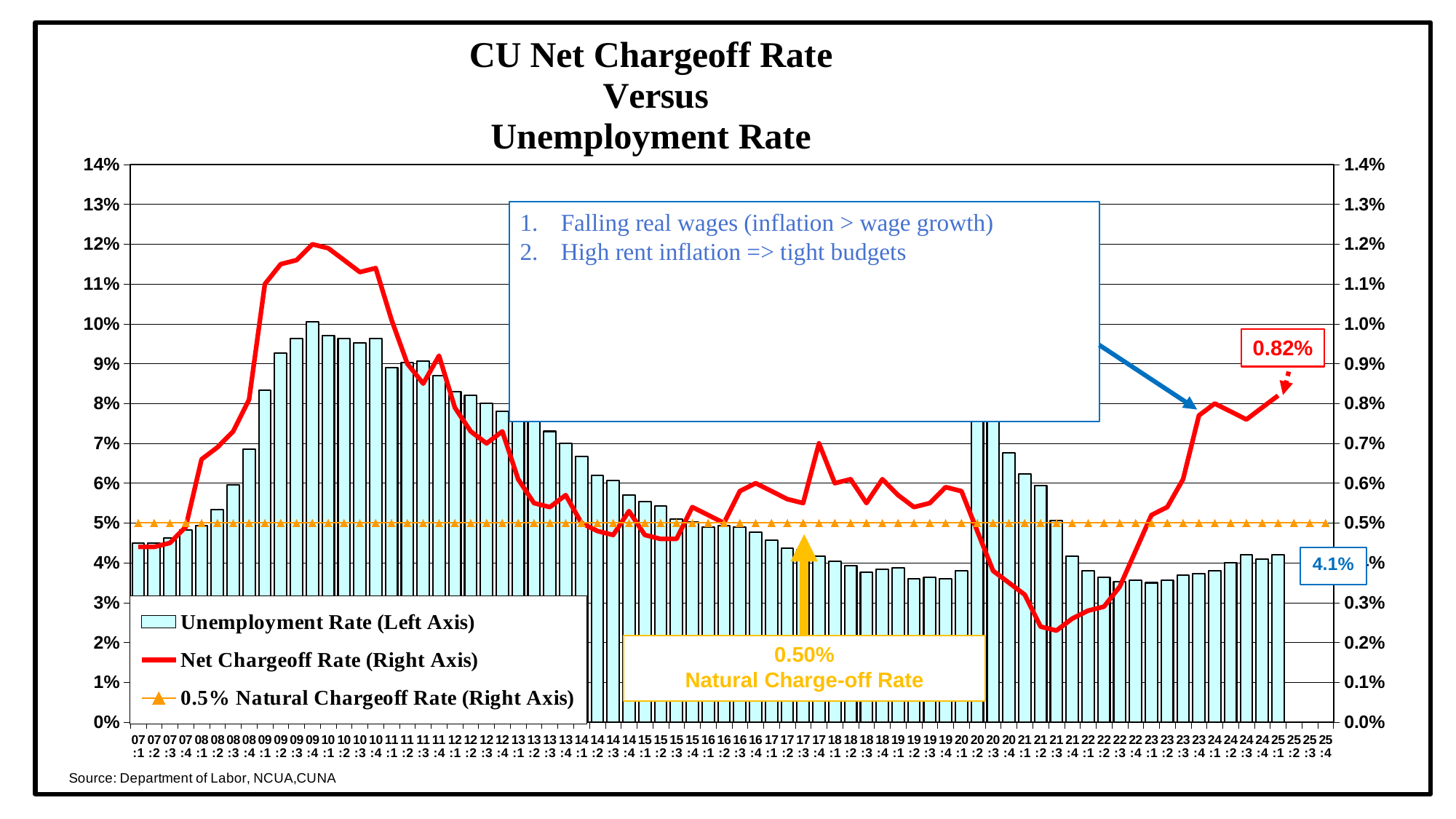
What kind of chart is this? Combined bar and line chart Does the Net Chargeoff Rate rise or fall from 21:3 to 23:4? rise What is the title of the chart? CU Net Chargeoff Rate Versus Unemployment Rate Does the Unemployment Rate rise or fall from 10:1 to 19:4? fall Which is larger, the Unemployment Rate in 09:4 or in 19:4? 09:4 Is the Net Chargeoff Rate in 09:4 greater or less than 1.1%? greater Is the Unemployment Rate in 07:1 greater or less than 5%? less How many series does the legend list? 3 What is the latest labelled value of the Unemployment Rate? 4.1% Is the Net Chargeoff Rate in 21:3 greater or less than 0.3%? less What is the latest labelled value of the Net Chargeoff Rate? 0.82% What value is given for the Natural Charge-off Rate? 0.50%